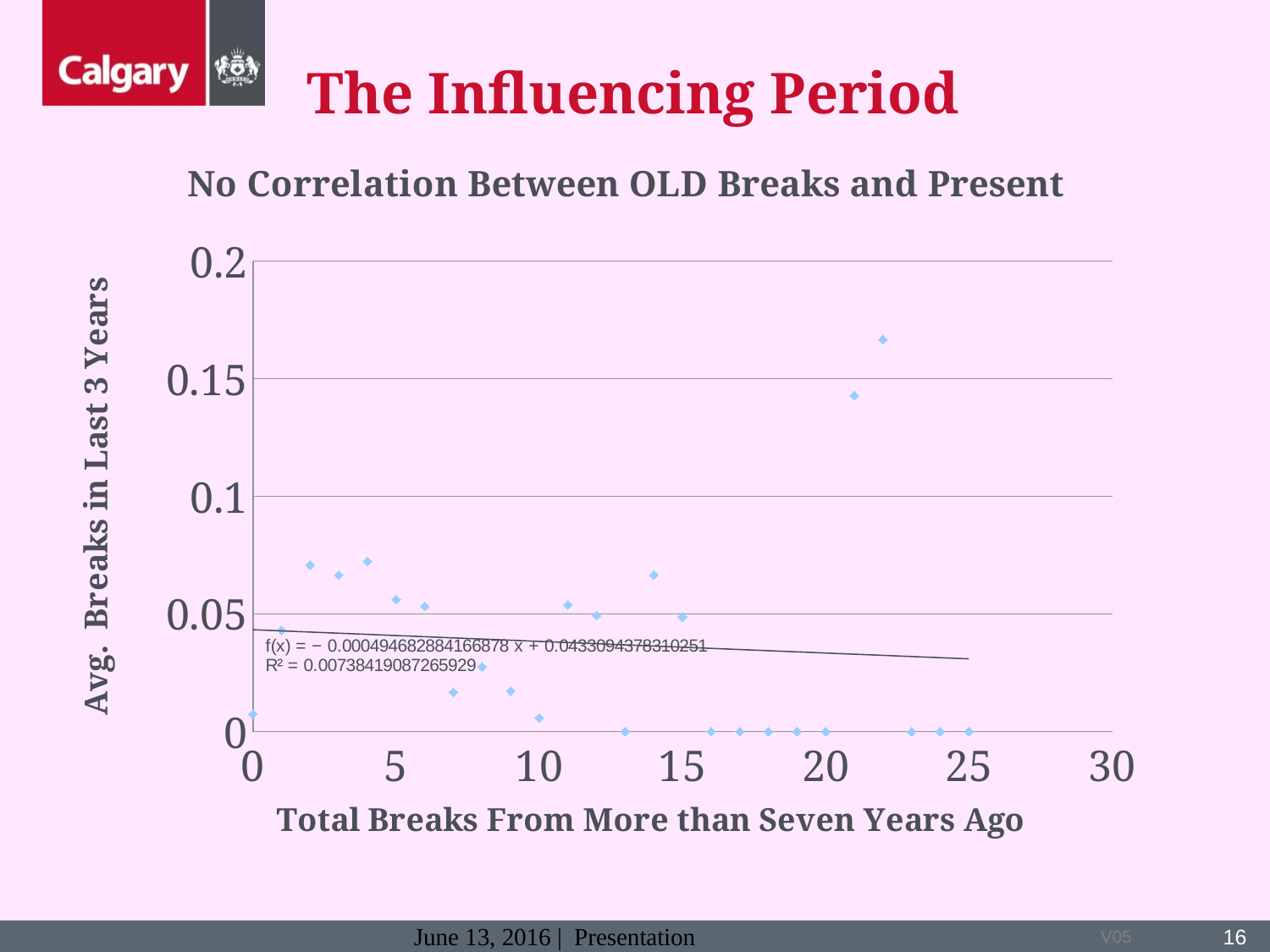
Which has the larger value, the point at x = 4 or the point at x = 7? x = 4 At which x value (Total Breaks From More than Seven Years Ago) is the highest point plotted? 22 What kind of chart is shown on the slide? scatter chart Is the value for x = 2 greater or less than 0.05? greater Is the value for x = 10 greater or less than 0.05? less What is the label of the x axis? Total Breaks From More than Seven Years Ago Which has the larger value, the point at x = 22 or the point at x = 21? x = 22 What is the title of the chart? No Correlation Between OLD Breaks and Present Does the fitted trendline rise or fall as x increases? fall What is the plotted value at x = 13? 0 Is the value for x = 22 greater or less than 0.15? greater